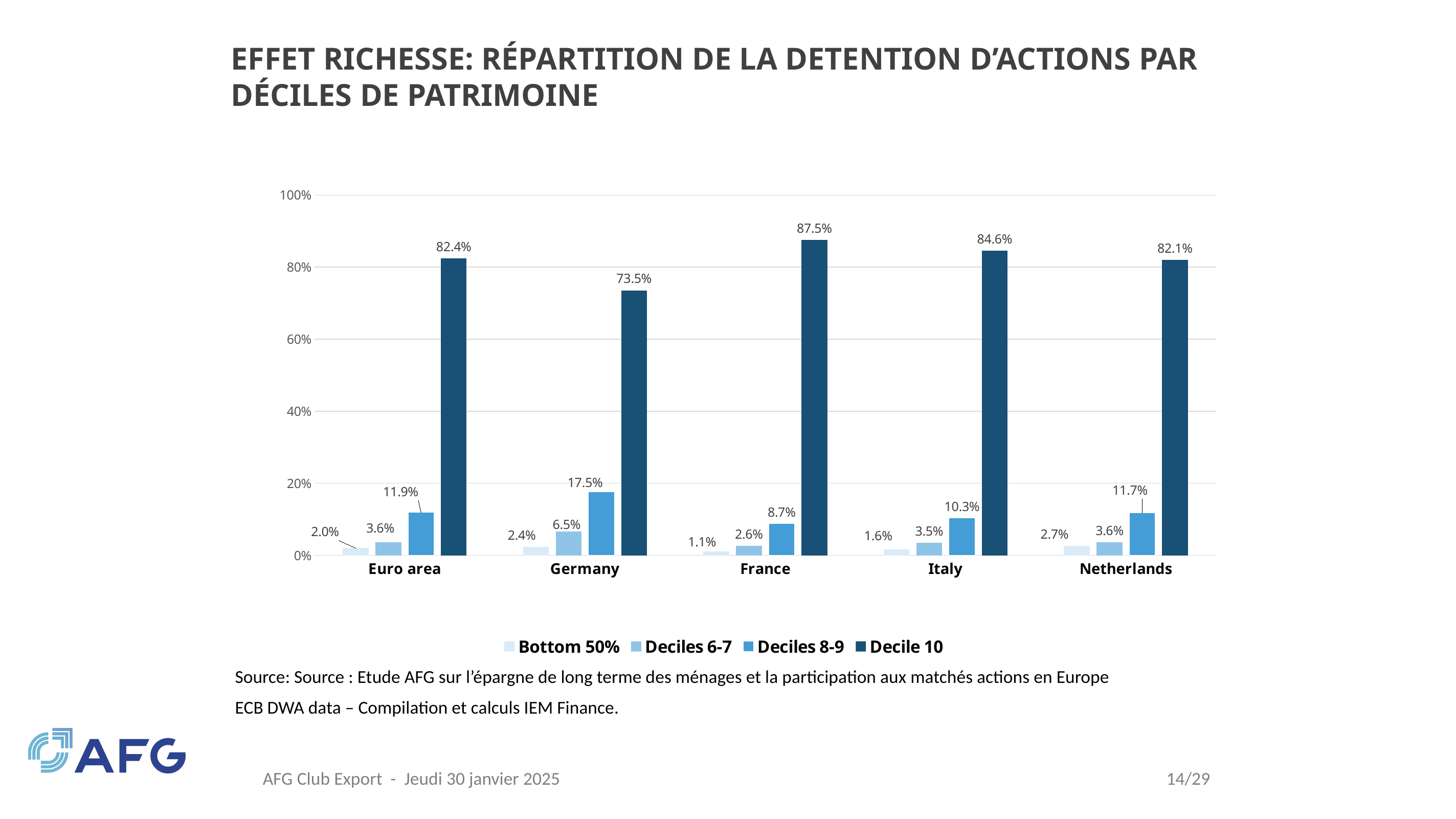
What is the value for Decile 10 in France? 87.5% Which is larger: Deciles 8-9 in the Euro area or Deciles 8-9 in the Netherlands? Euro area Which country has the lowest value for Decile 10? Germany How many series does the legend list? 4 What kind of chart is shown on the slide? Bar chart Which category has the lowest value for Bottom 50%? France What is the difference between the Decile 10 values for France and Germany? 14.0% How many categories are shown on the x axis? 5 What is the value for Deciles 8-9 in Germany? 17.5% What is the value for Bottom 50% in Italy? 1.6% Which country has the highest value for Decile 10? France What is the value for Deciles 6-7 in the Netherlands? 3.6%